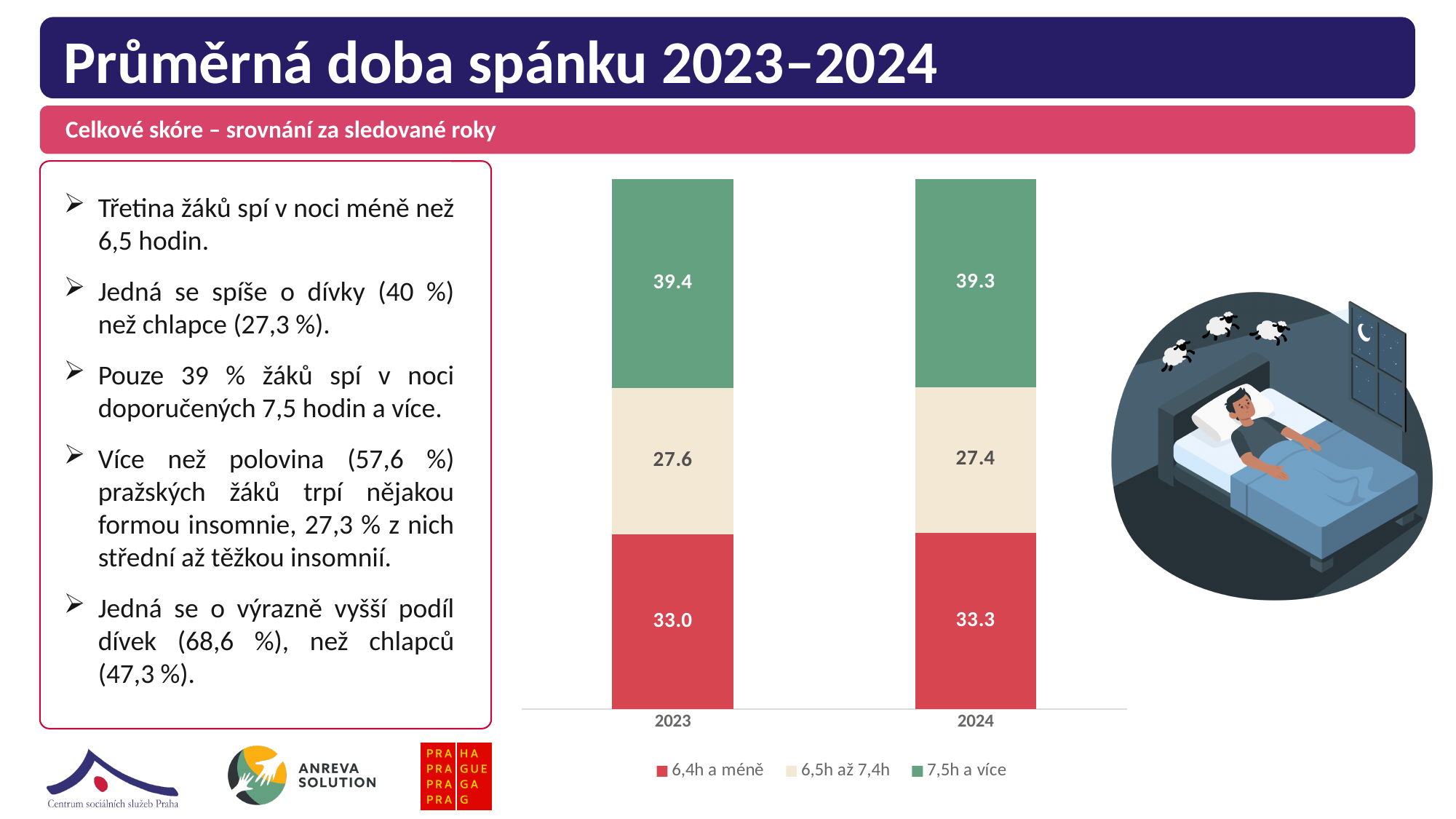
What is the value for "7,5h a více" in 2023? 39.4 Is the "6,4h a méně" value larger in 2023 or in 2024? 2024 How many categories are shown on the x axis? 2 Which series has the smallest segment in the 2023 bar? 6,5h až 7,4h How many series does the legend list? 3 What is the value for "6,4h a méně" in 2024? 33.3 Which series has the largest segment in the 2024 bar? 7,5h a více What kind of chart is shown on the slide? Stacked bar chart What is the total of the stacked bar for 2024? 100.0 What is the value for "6,5h až 7,4h" in 2023? 27.6 What is the value for "7,5h a více" in 2024? 39.3 What is the difference between the "7,5h a více" value and the "6,4h a méně" value in 2023? 6.4